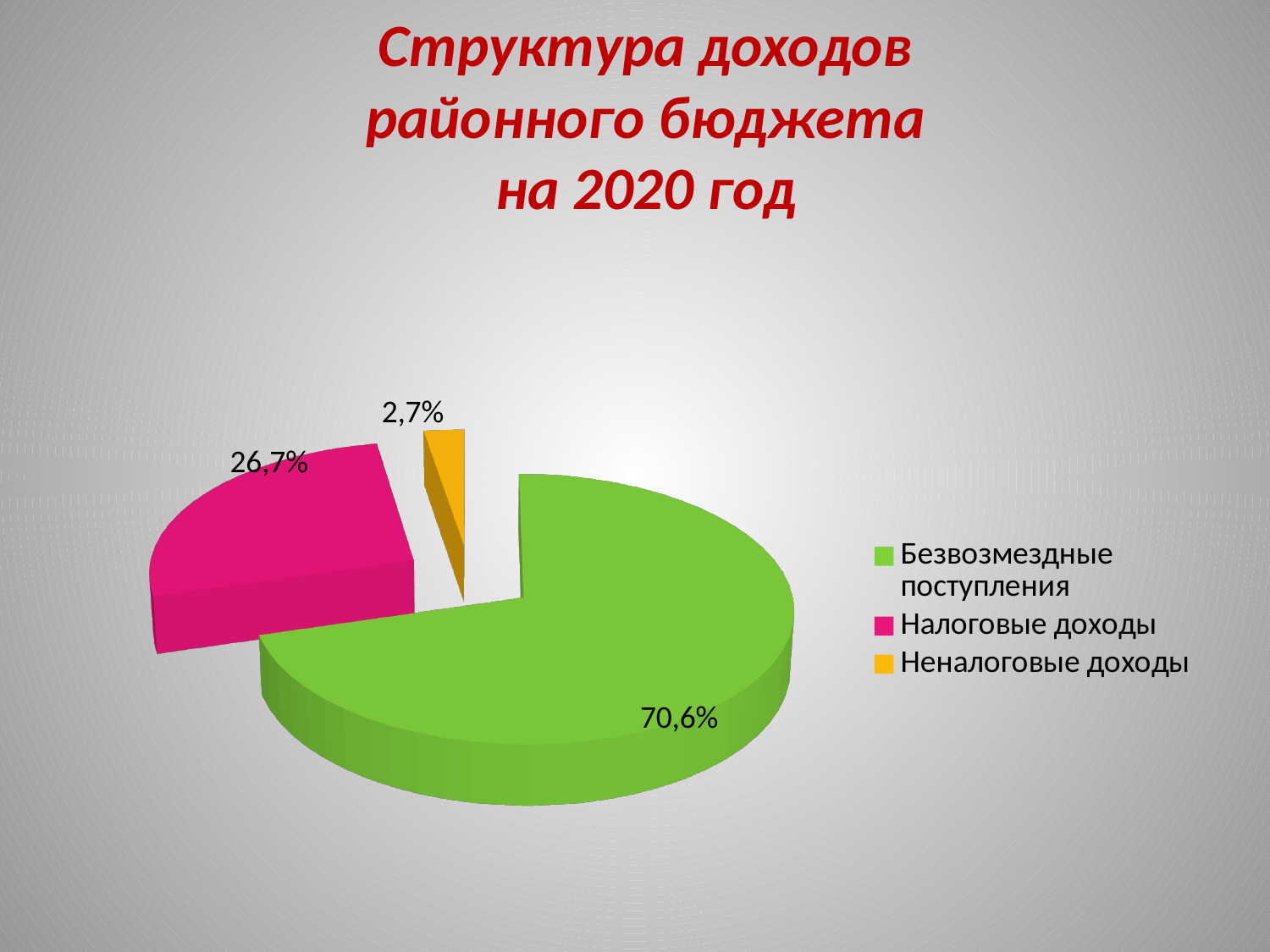
What share of the pie does Налоговые доходы have? 26,7% Which category has the largest slice of the pie? Безвозмездные поступления What share of the pie does Неналоговые доходы have? 2,7% How many slices does the pie chart have? 3 Which is larger: Налоговые доходы or Неналоговые доходы? Налоговые доходы What share of the pie does Безвозмездные поступления have? 70,6% What kind of chart is shown on the slide? Pie chart What is the difference in percentage points between Налоговые доходы and Неналоговые доходы? 24,0 What colour is the slice for Налоговые доходы? Pink What is the difference in percentage points between Безвозмездные поступления and Налоговые доходы? 43,9 Which category has the smallest slice of the pie? Неналоговые доходы How many entries does the legend list? 3